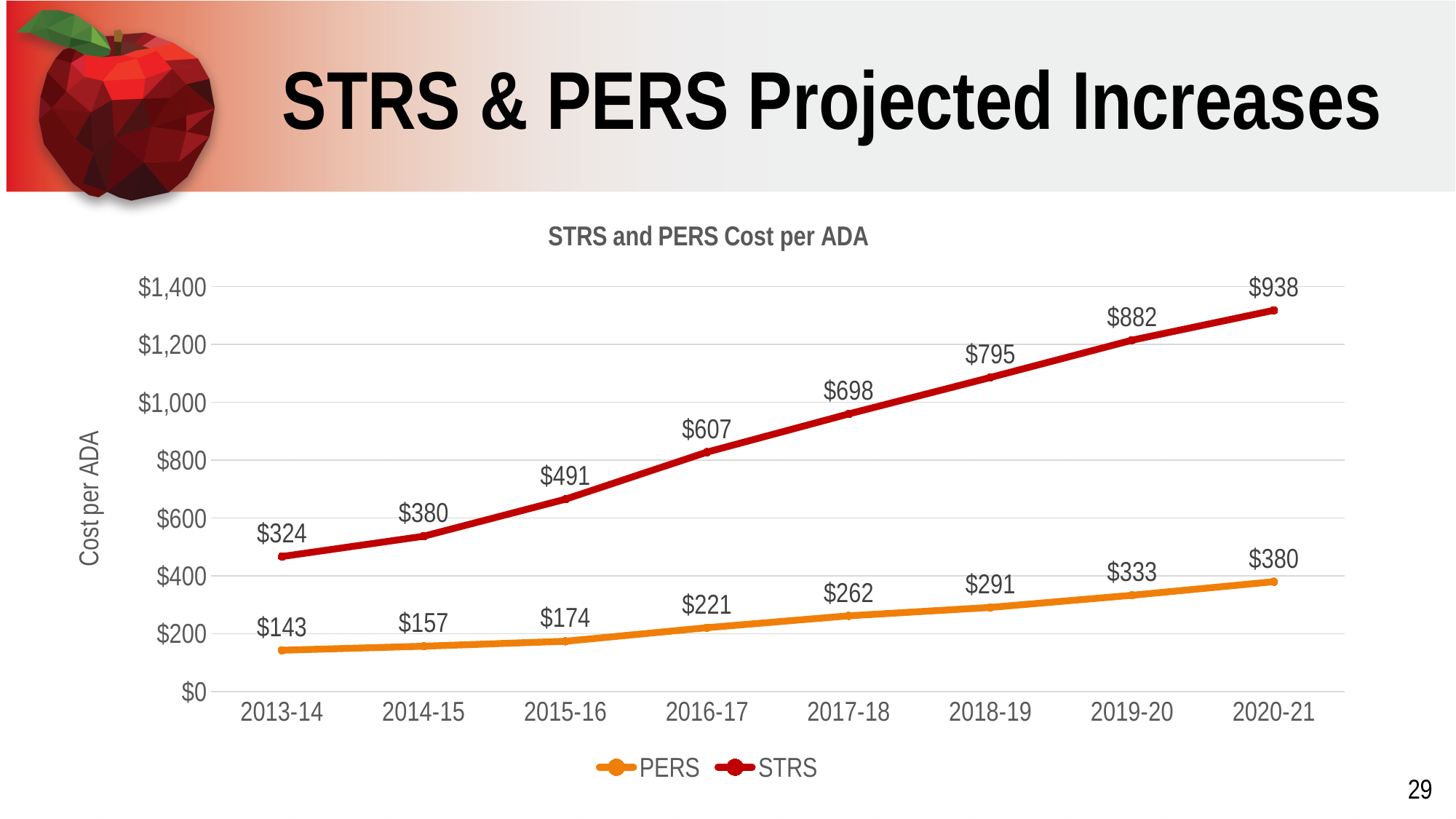
What is the STRS cost per ADA for 2016-17? $607 Do the PERS values rise or fall from 2013-14 to 2020-21? Rise In which year is the PERS cost per ADA lowest? 2013-14 What is the PERS cost per ADA for 2018-19? $291 What is the STRS value for 2020-21? $938 Which is larger in 2015-16, the STRS value or the PERS value? STRS How many series does the legend list? 2 What is the difference between the STRS and PERS values in 2019-20? $549 By how much does the PERS value increase from 2013-14 to 2020-21? $237 In which year is the STRS cost per ADA highest? 2020-21 How many years are shown on the x axis? 8 What kind of chart is shown? Line chart